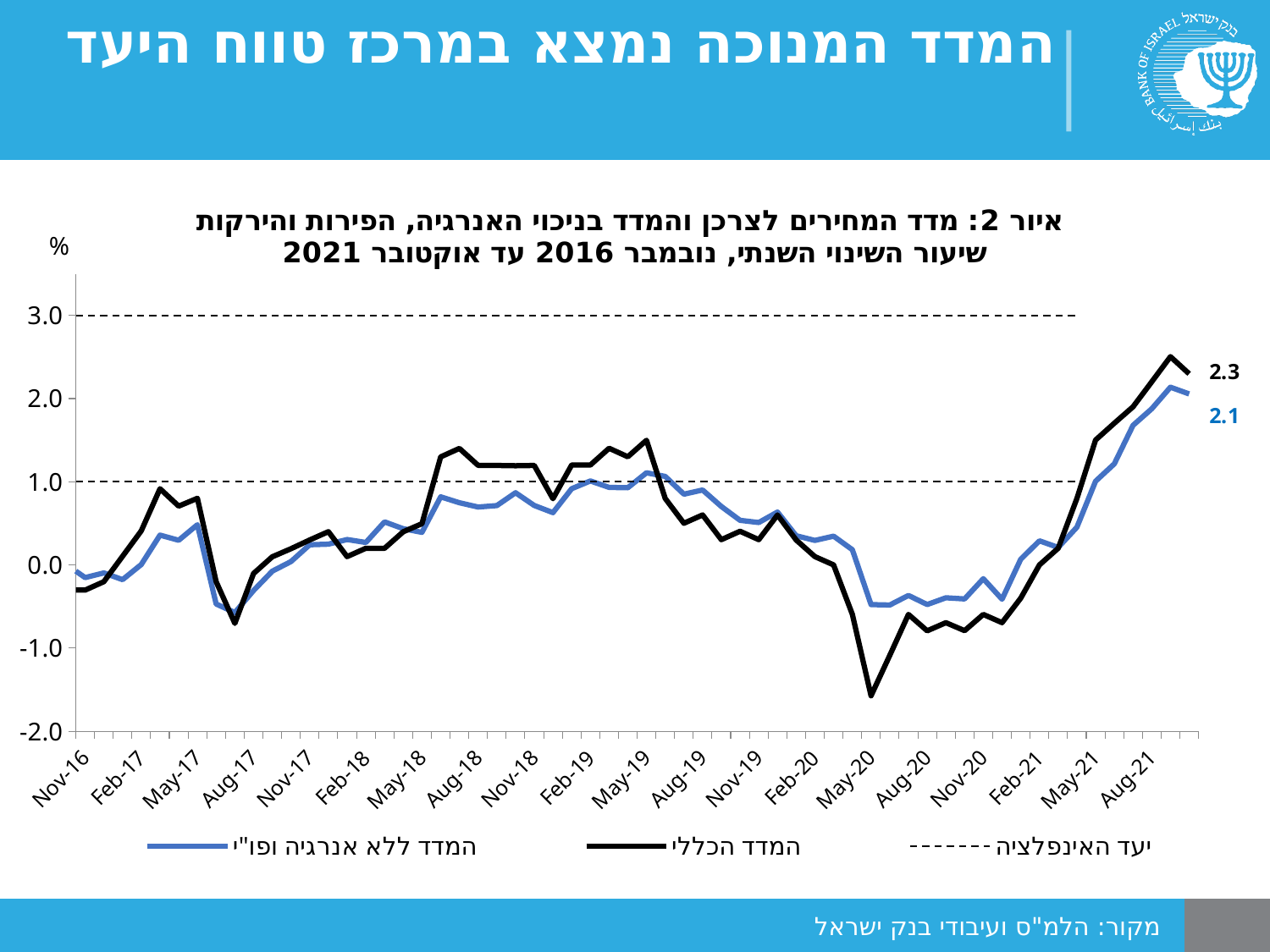
What is the last labelled value of the המדד הכללי series? 2.3 Does the המדד הכללי series rise or fall between May-20 and Aug-21? rise How many series does the legend list? 3 At the end of the period, which series has the higher labelled value: המדד הכללי or המדד ללא אנרגיה ופו"י? המדד הכללי What is the last labelled value of the המדד ללא אנרגיה ופו"י series? 2.1 What kind of chart is shown on the slide? line chart What do the dashed horizontal lines on the chart represent, according to the legend? יעד האינפלציה Is the value of המדד ללא אנרגיה ופו"י at May-20 greater or less than -1.0? greater Is the value of המדד הכללי at Aug-21 greater or less than 2.0? greater At which two y-axis values are the dashed יעד האינפלציה lines drawn? 1.0 and 3.0 What is the difference between the final labelled values of המדד הכללי (2.3) and המדד ללא אנרגיה ופו"י (2.1)? 0.2 Is the value of המדד הכללי at May-20 greater or less than -1.0? less